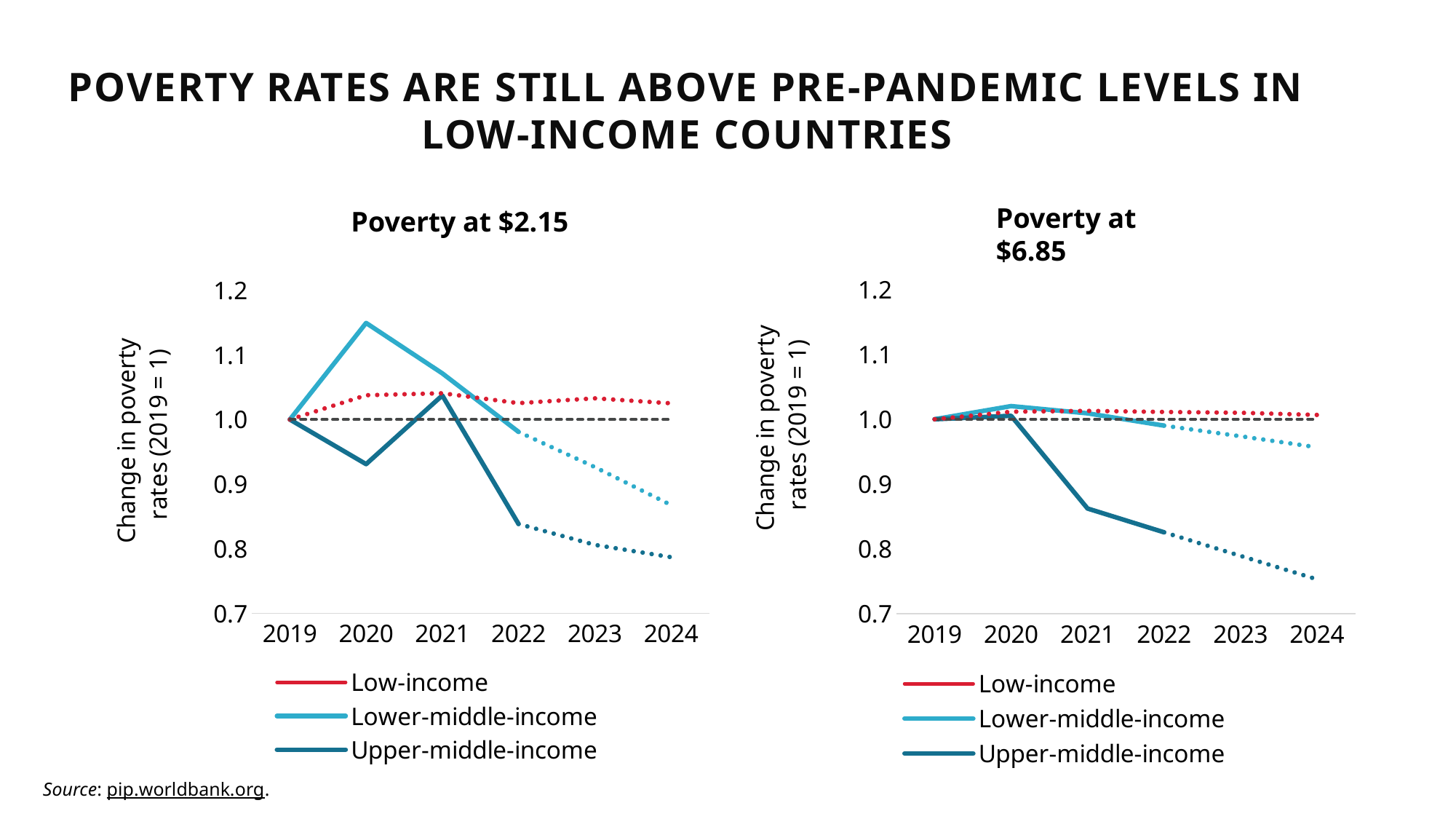
In the 'Poverty at $6.85' chart, which is larger in 2024: Low-income or Lower-middle-income? Low-income In the 'Poverty at $2.15' chart, is the value for Upper-middle-income in 2024 greater or less than 0.8? less In the 'Poverty at $6.85' chart, does the Upper-middle-income series rise or fall from 2020 to 2024? fall In the 'Poverty at $2.15' chart, which series has the lowest value in 2024? Upper-middle-income In the 'Poverty at $6.85' chart, how many years are shown on the x axis? 6 In the 'Poverty at $6.85' chart, which series has the lowest value in 2022? Upper-middle-income What is the y-axis label of the 'Poverty at $2.15' chart? Change in poverty rates (2019 = 1) In the 'Poverty at $2.15' chart, how many series does the legend list? 3 In the 'Poverty at $2.15' chart, what kind of chart is shown? line chart In the 'Poverty at $2.15' chart, is the value for Lower-middle-income in 2020 greater or less than 1.1? greater In the 'Poverty at $2.15' chart, which series has the highest value in 2020? Lower-middle-income In the 'Poverty at $6.85' chart, is the value for Upper-middle-income in 2021 greater or less than 0.9? less